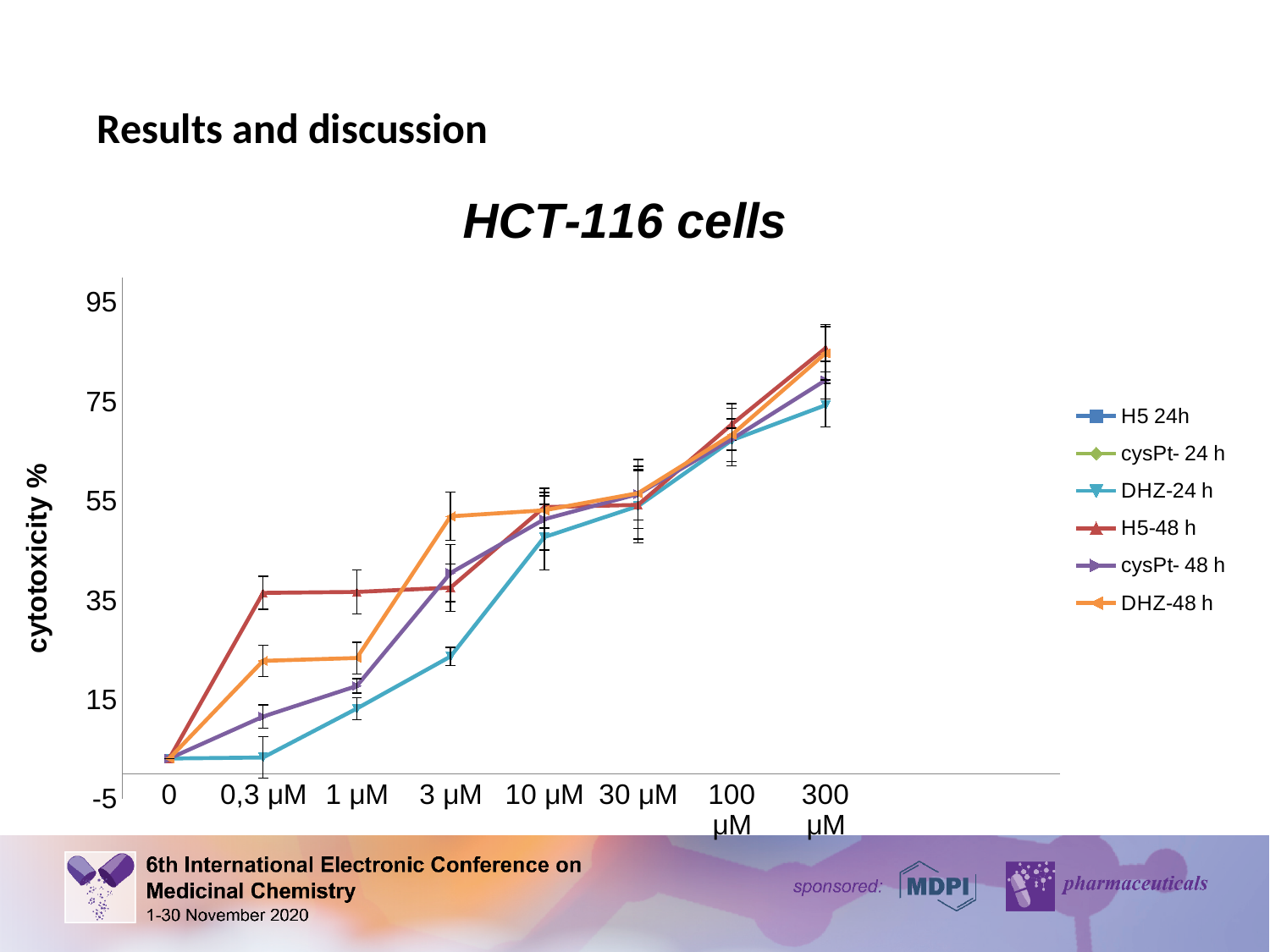
Is the value for DHZ-24 h at 100 µM greater or less than 75? less What kind of chart is shown on the slide? line chart What is the label of the y axis? cytotoxicity % At 1 µM, which is larger: H5-48 h or DHZ-24 h? H5-48 h Is the value for H5-48 h at 0,3 µM greater or less than 15? greater Does the DHZ-24 h series rise or fall as concentration increases along the x axis? rise What is the title of the chart? HCT-116 cells How many series does the legend list? 6 Is the value for H5-48 h at 300 µM greater or less than 75? greater At 0,3 µM, which series has the highest cytotoxicity? H5-48 h How many concentration categories are shown on the x axis? 8